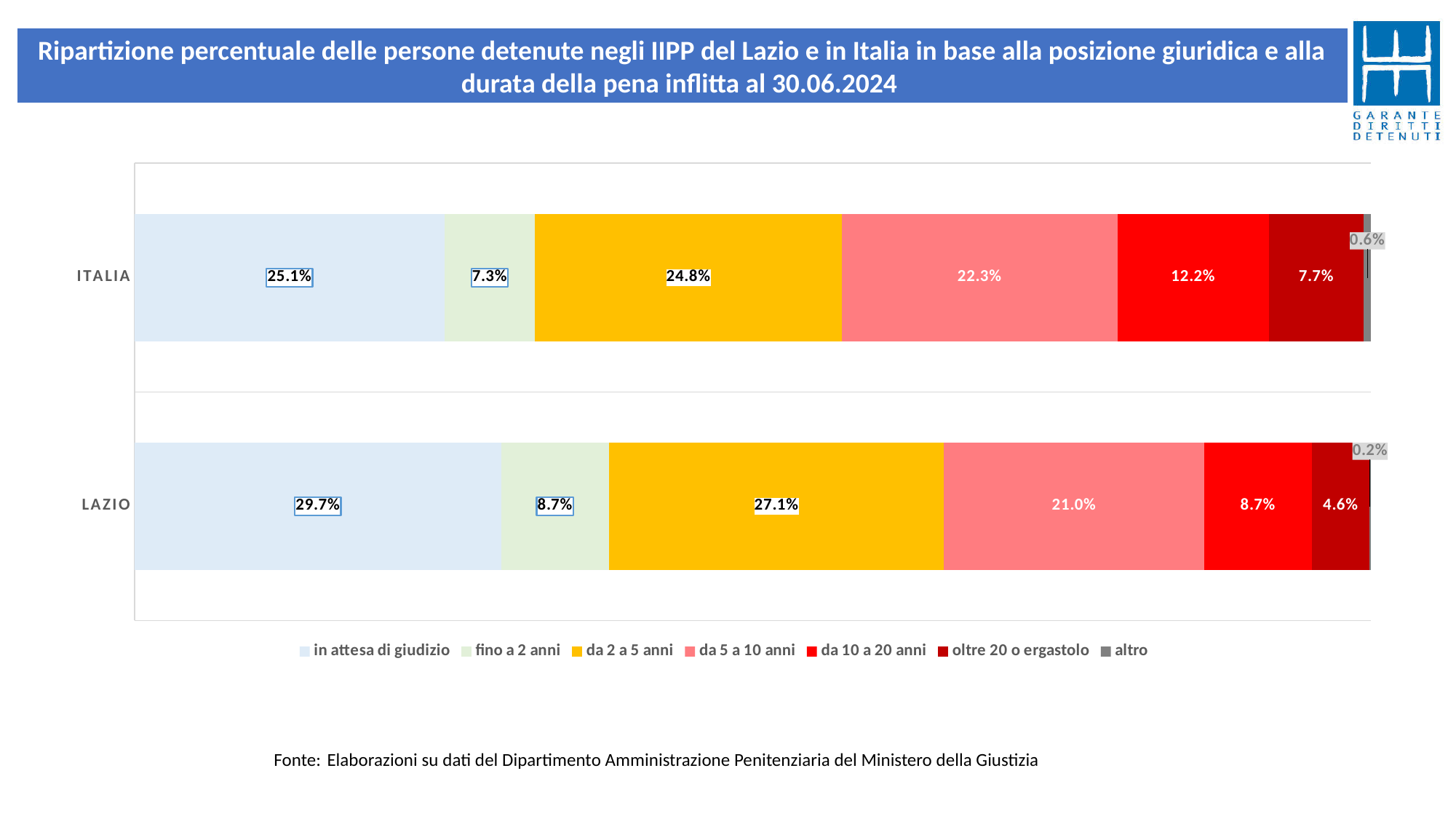
What is the value for 'da 2 a 5 anni' in the LAZIO bar? 27.1% What is the value for 'altro' in the LAZIO bar? 0.2% How many series does the legend list? 7 Which has a larger 'da 5 a 10 anni' share, ITALIA or LAZIO? ITALIA What is the value for 'oltre 20 o ergastolo' in the ITALIA bar? 7.7% How many categories (bars) are shown in the chart? 2 Which segment is the largest in the ITALIA bar? in attesa di giudizio Which segment is the smallest in the LAZIO bar? altro What percentage of detainees in ITALIA are 'in attesa di giudizio'? 25.1% What kind of chart is shown on the slide? Stacked bar chart What percentage of detainees in LAZIO are 'in attesa di giudizio'? 29.7% What is the difference between the 'da 10 a 20 anni' values for ITALIA and LAZIO? 3.5%